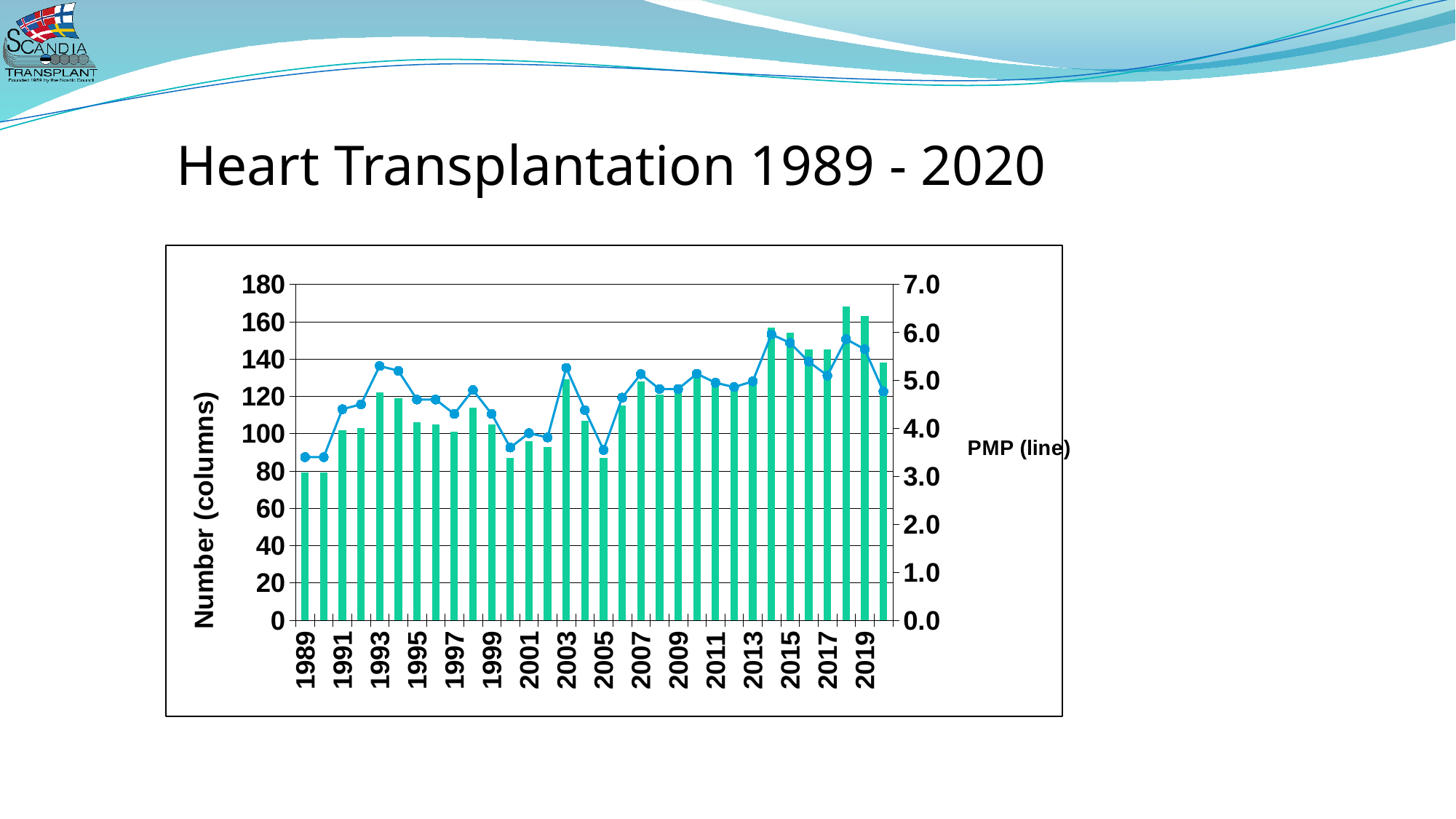
Which year has the taller bar, 2003 or 2005? 2003 Is the number of heart transplantations (bar) for 2018 greater or less than 160? greater How many years (bars) are plotted in the chart? 32 Is the PMP value (line) for 1993 greater or less than 5.0? greater Is the PMP value (line) for 2005 greater or less than 4.0? less What kind of chart is shown on the slide? A combined bar and line chart Does the number of heart transplantations (bars) rise or fall from 2013 to 2014? rise Which year has the tallest bar (highest number of heart transplantations)? 2018 What is the title of the chart on the slide? Heart Transplantation 1989 - 2020 What is the label of the left vertical axis? Number (columns)